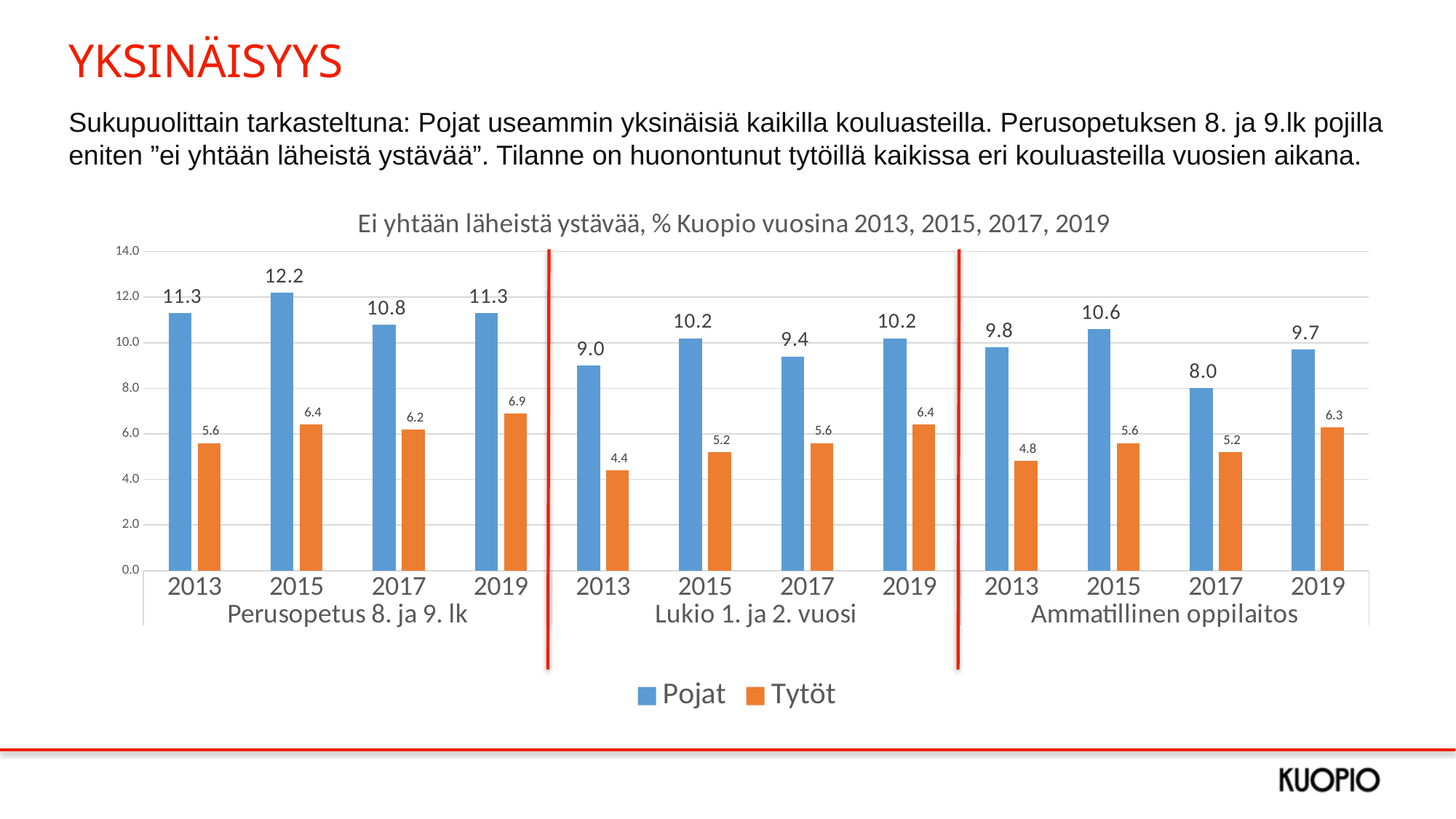
What is the value for Tytöt in 2013 in the Lukio 1. ja 2. vuosi group? 4.4 Which year has the highest Pojat value in the Perusopetus 8. ja 9. lk group? 2015 Do the Tytöt values rise or fall from 2013 to 2019 in the Perusopetus 8. ja 9. lk group? Rise How many school-level groups are shown on the x axis of the chart? 3 What is the value for Pojat in 2015 in the Perusopetus 8. ja 9. lk group? 12.2 What kind of chart is shown on the slide? Bar chart Which year has the lowest Tytöt value in the Lukio 1. ja 2. vuosi group? 2013 Which is larger: the Pojat value in 2013 for Lukio 1. ja 2. vuosi or the Pojat value in 2013 for Ammatillinen oppilaitos? Ammatillinen oppilaitos What is the value for Pojat in 2017 in the Ammatillinen oppilaitos group? 8.0 How many series does the legend list? 2 What is the title of the chart? Ei yhtään läheistä ystävää, % Kuopio vuosina 2013, 2015, 2017, 2019 What is the difference between the Pojat and Tytöt values in 2019 in the Ammatillinen oppilaitos group? 3.4